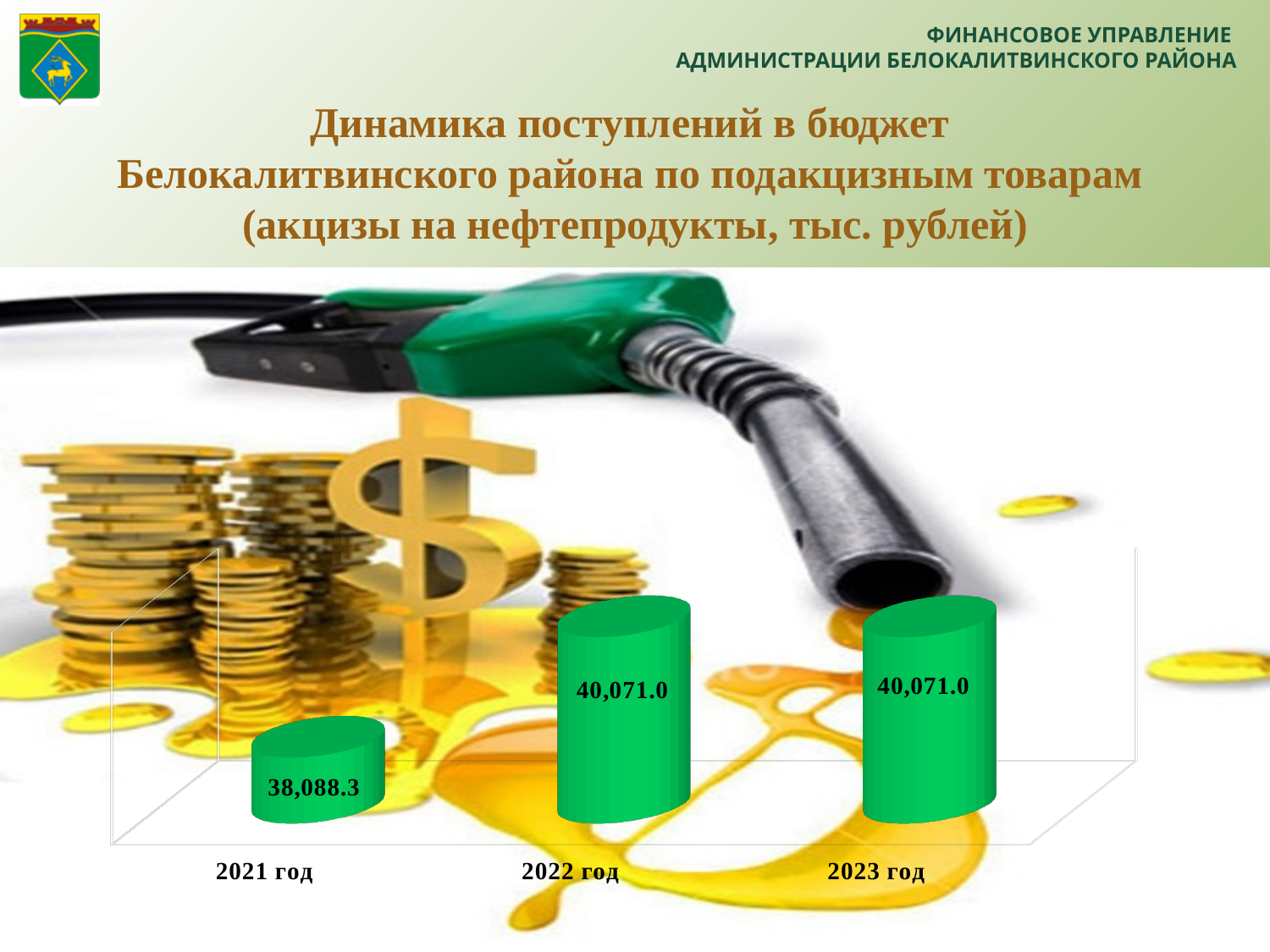
What is the difference between the values for 2022 год and 2021 год? 1,982.7 What is the value for 2021 год? 38,088.3 What kind of chart is shown on the slide? bar chart Which year has the lowest value? 2021 год What is the value for 2022 год? 40,071.0 How many years are shown on the chart? 3 Do the values rise or fall from 2021 год to 2022 год? rise What colour are the bars on the chart? green Is the value for 2021 год greater or less than 40,000? less Is the value for 2023 год larger than, smaller than, or the same as the value for 2022 год? the same Which is larger, the value for 2021 год or the value for 2022 год? 2022 год What is the value for 2023 год? 40,071.0